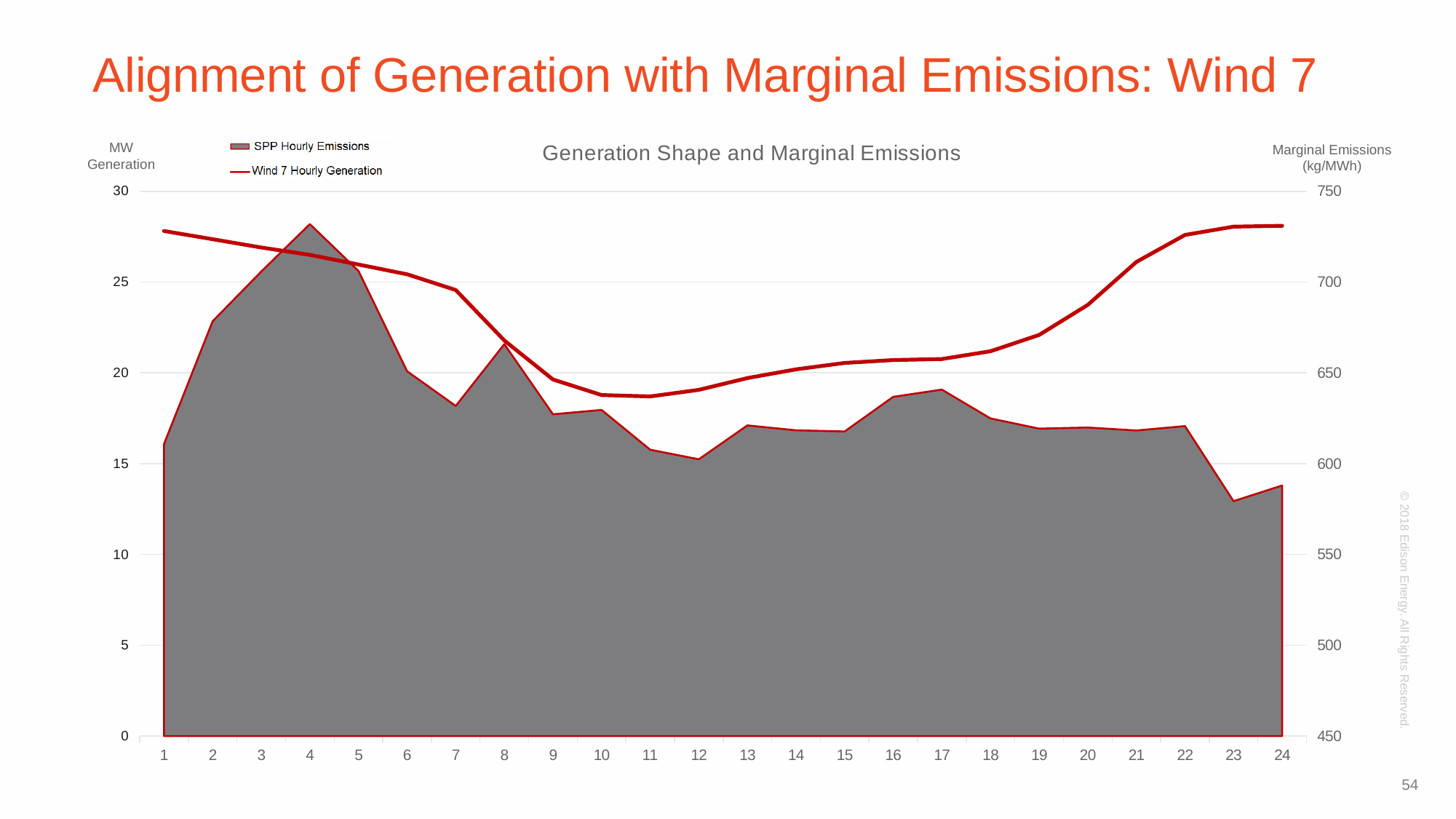
Which is larger for SPP Hourly Emissions: the value at hour 4 or the value at hour 12? Hour 4 How many series does the chart legend list? 2 Does the Wind 7 Hourly Generation line rise or fall from hour 12 to hour 24? Rise At which hour does the SPP Hourly Emissions area reach its lowest value? 23 Does the SPP Hourly Emissions area rise or fall from hour 4 to hour 7? Fall At which hour does the SPP Hourly Emissions area reach its highest value? 4 What kind of chart is shown on the slide? Combined area and line chart What is the title of the chart? Generation Shape and Marginal Emissions Which is larger for Wind 7 Hourly Generation: the value at hour 1 or the value at hour 11? Hour 1 Does the Wind 7 Hourly Generation line rise or fall from hour 1 to hour 11? Fall How many hourly points are plotted along the x axis? 24 What is the label of the right-hand vertical axis? Marginal Emissions (kg/MWh)